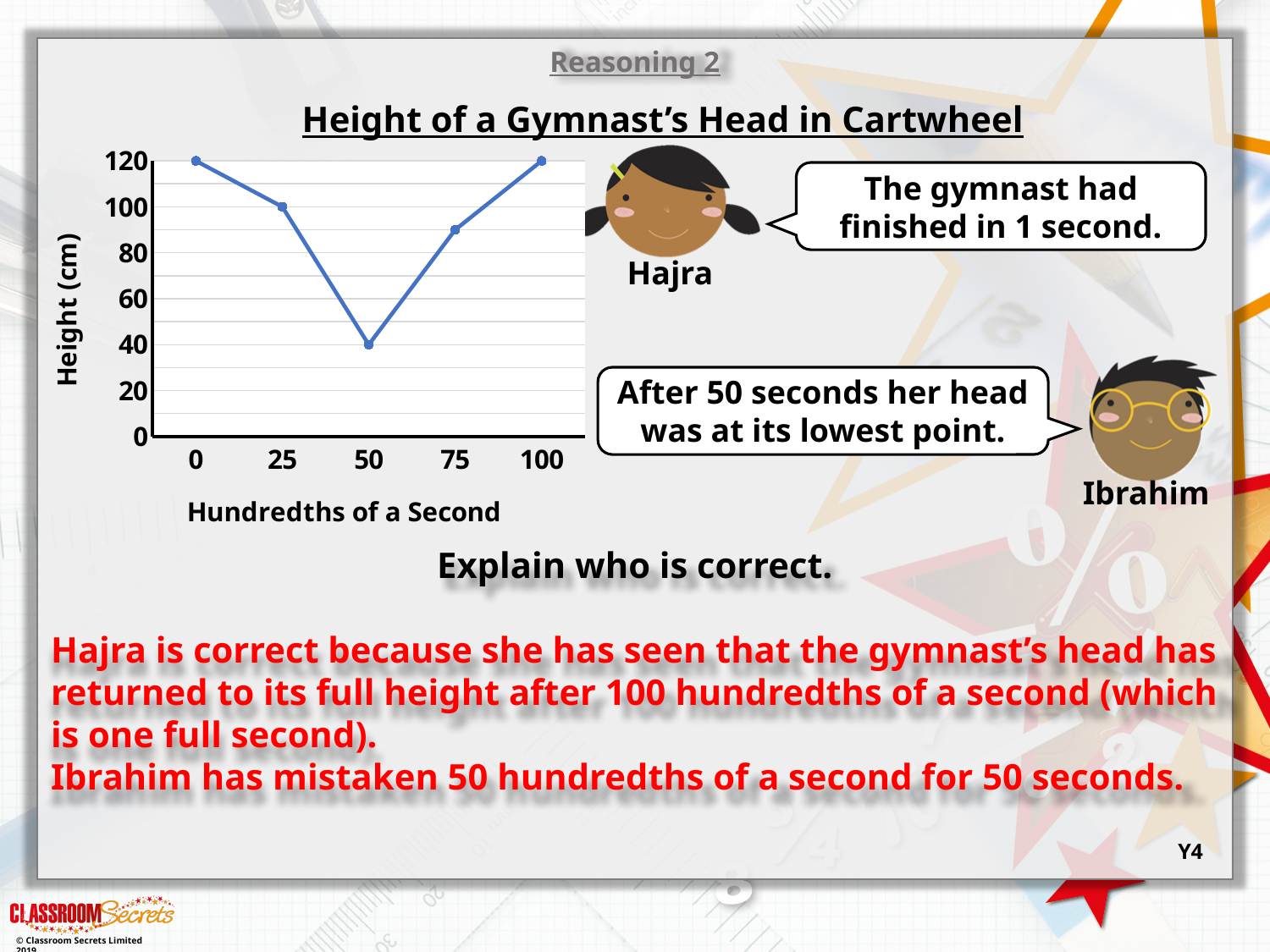
What is the difference in height between 0 and 50 hundredths of a second? 80 What is the height of the gymnast's head at 50 hundredths of a second? 40 How many data points are plotted on the line? 5 At which time (in hundredths of a second) is the height of the gymnast's head lowest? 50 What is the height of the gymnast's head at 25 hundredths of a second? 100 What kind of chart is shown on the slide? line chart What is the height of the gymnast's head at 100 hundredths of a second? 120 Is the height at 75 hundredths of a second greater or less than 80? greater Does the height rise or fall between 0 and 50 hundredths of a second? fall Which is higher: the height at 25 hundredths of a second or at 75 hundredths of a second? 25 hundredths of a second What is the height of the gymnast's head at 0 hundredths of a second? 120 What is the title of the chart? Height of a Gymnast's Head in Cartwheel